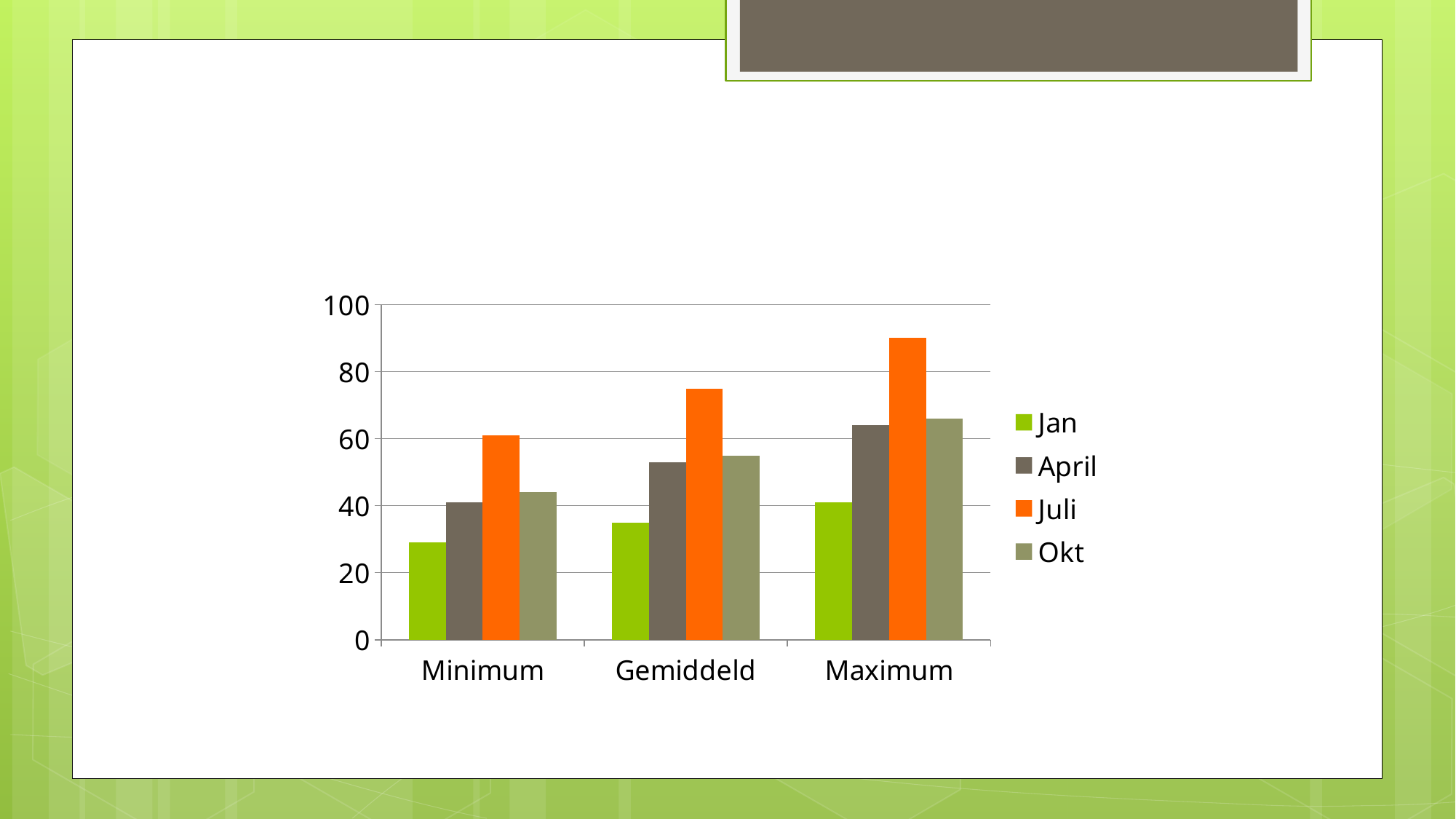
Is the value for Juli in the Maximum category greater or less than 80? greater How many categories are shown on the x axis? 3 How many series does the legend list? 4 What kind of chart is shown on the slide? bar chart Which colour represents the Juli series in the legend? orange Which series has the lowest bar in the Minimum category? Jan Is the value for Jan in the Minimum category greater or less than 40? less Do the Juli values rise or fall from Minimum to Maximum along the x axis? rise Which series has the highest bar in the Maximum category? Juli Which is larger in the Minimum category, the Jan bar or the April bar? April Is the value for Juli in the Gemiddeld category greater or less than 60? greater In which category is the Juli bar the tallest? Maximum